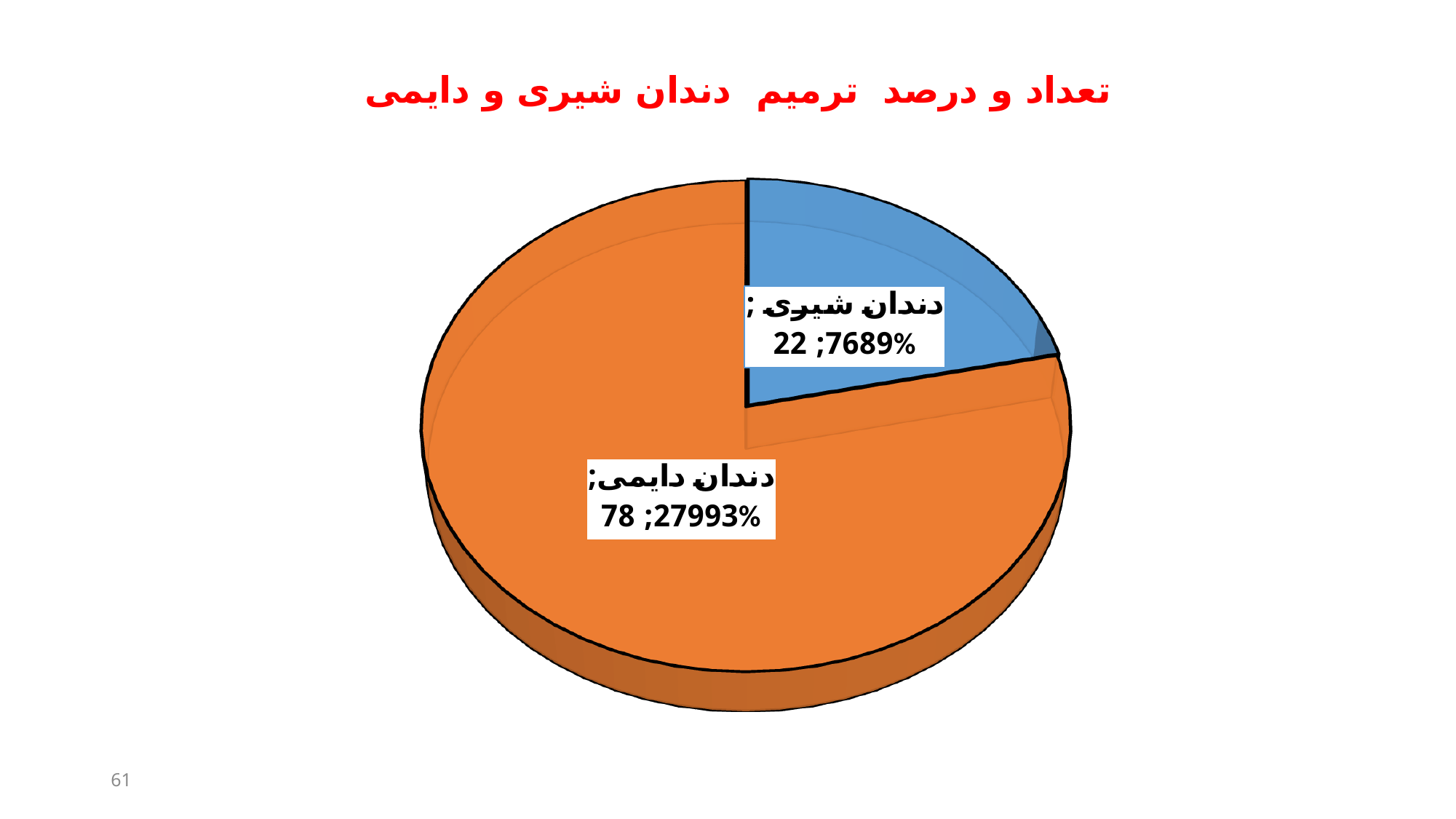
What colour is the slice for دندان شیری (primary teeth)? blue Which slice is the smallest in the pie chart? دندان شیری What kind of chart is shown on the slide? pie chart Which slice is the largest in the pie chart? دندان دایمی What is the value shown for دندان دایمی (permanent teeth)? 27993 How many slices does the pie chart have? 2 Which is larger, the value for دندان شیری or the value for دندان دایمی? دندان دایمی What is the value shown for دندان شیری (primary teeth)? 7689 What is the difference between the values for دندان دایمی and دندان شیری? 20304 What percentage share of the pie does دندان دایمی (permanent teeth) have? 78% What is the total of the two values shown in the pie chart? 35682 What percentage share of the pie does دندان شیری (primary teeth) have? 22%